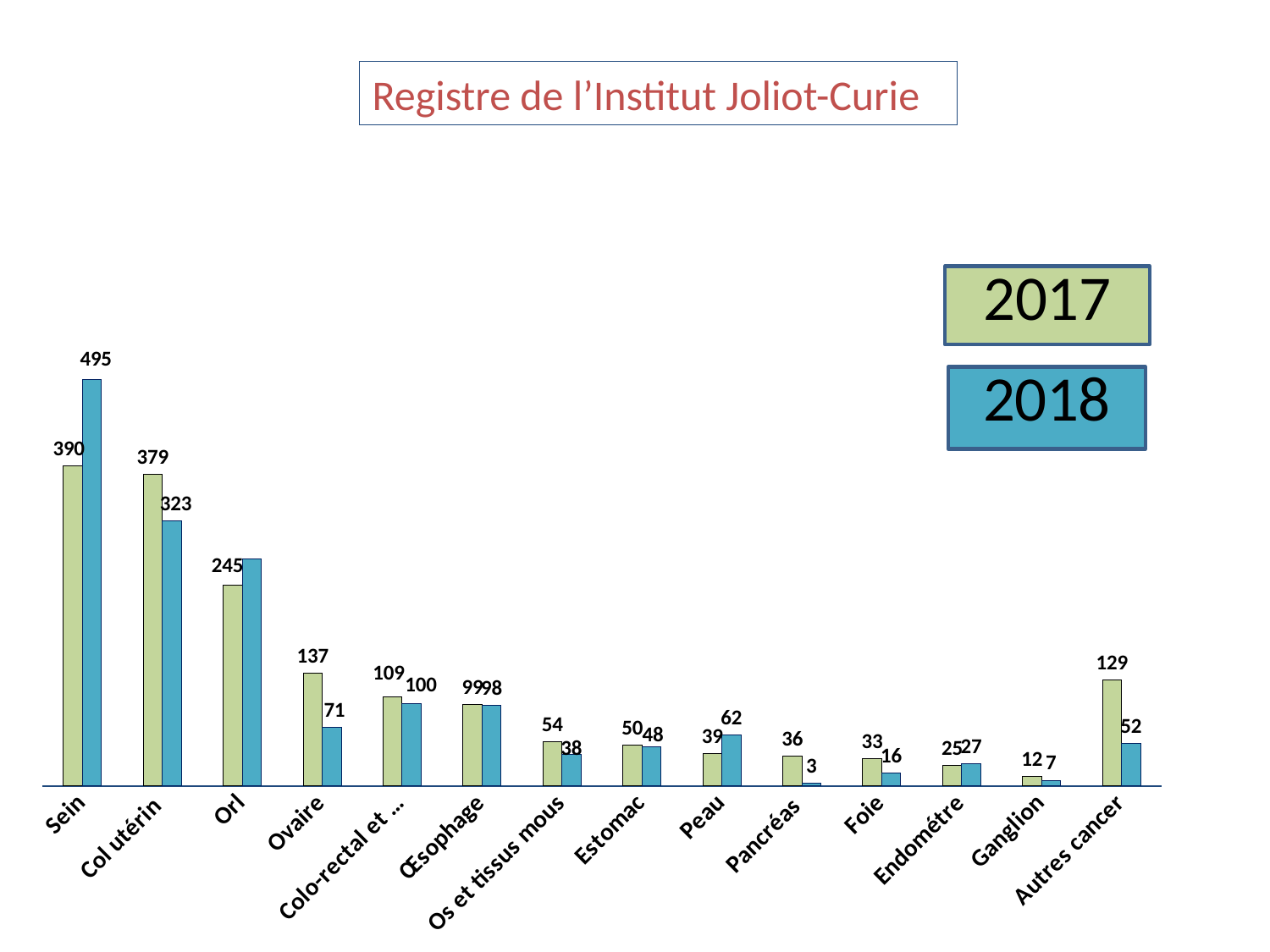
What is the difference between the 2017 and 2018 values for Col utérin? 56 Which category has the highest 2018 value? Sein What kind of chart is shown on the slide? Bar chart How many series does the legend list? 2 For Orl, which year has the larger value, 2017 or 2018? 2018 What is the difference between the 2018 and 2017 values for Sein? 105 What is the 2017 value for Autres cancer? 129 What is the 2017 value for Ovaire? 137 What is the 2018 value for Sein? 495 For Peau, which year has the larger value, 2017 or 2018? 2018 How many categories are shown on the x axis? 14 Which category has the lowest 2018 value? Pancréas